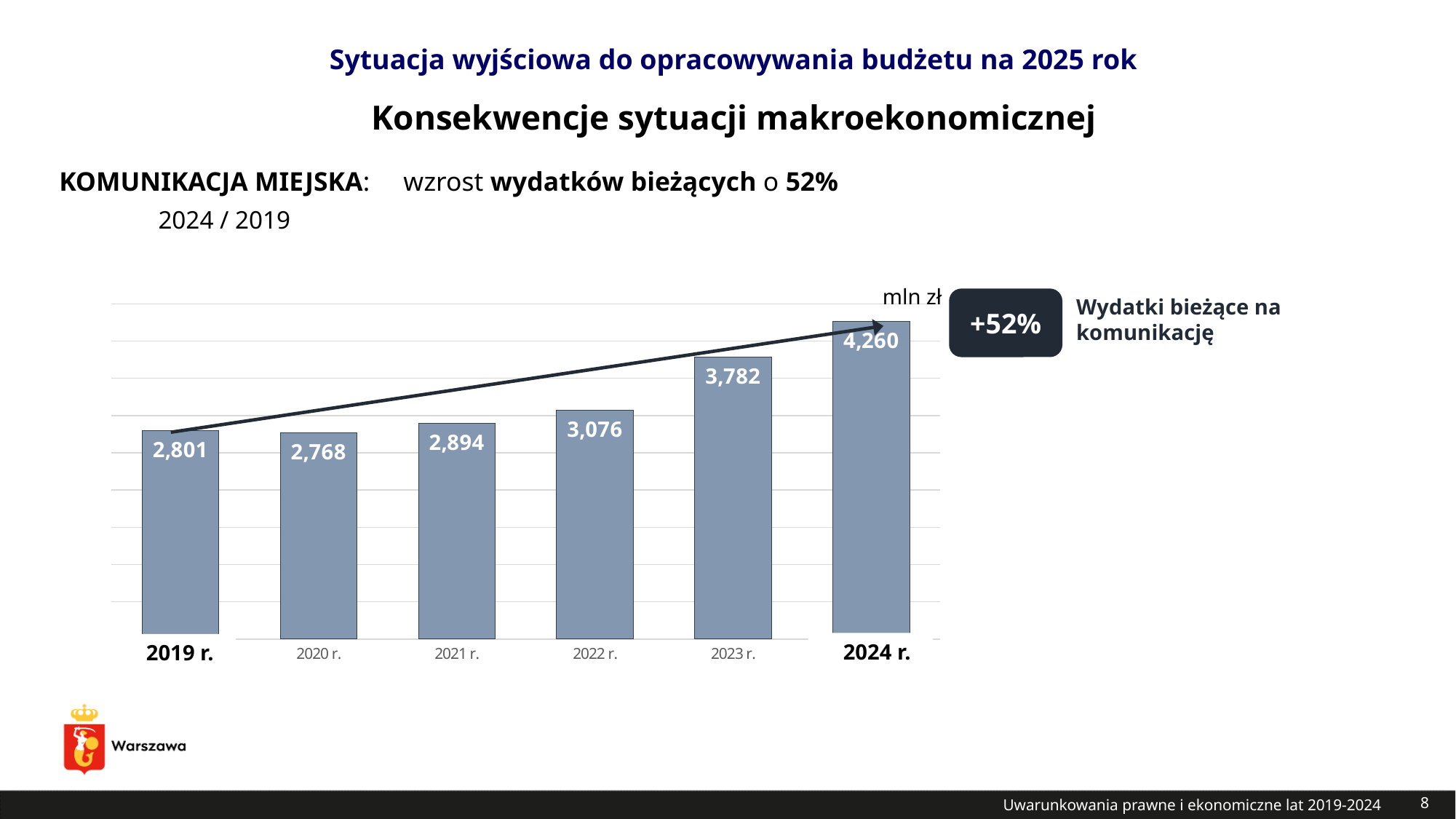
What percentage increase is shown in the dark box next to the chart? +52% What is the value for 2024 r.? 4,260 What is the value for 2019 r.? 2,801 Which year has the lowest value? 2020 r. What is the difference between the values for 2024 r. and 2019 r.? 1,459 Do the values generally rise or fall from 2020 r. to 2024 r.? rise Which year has the highest value? 2024 r. What kind of chart is shown on the slide? bar chart What is the difference between the values for 2023 r. and 2022 r.? 706 How many years are shown on the x axis? 6 Which is larger, the value for 2021 r. or the value for 2020 r.? 2021 r. What is the value for 2022 r.? 3,076